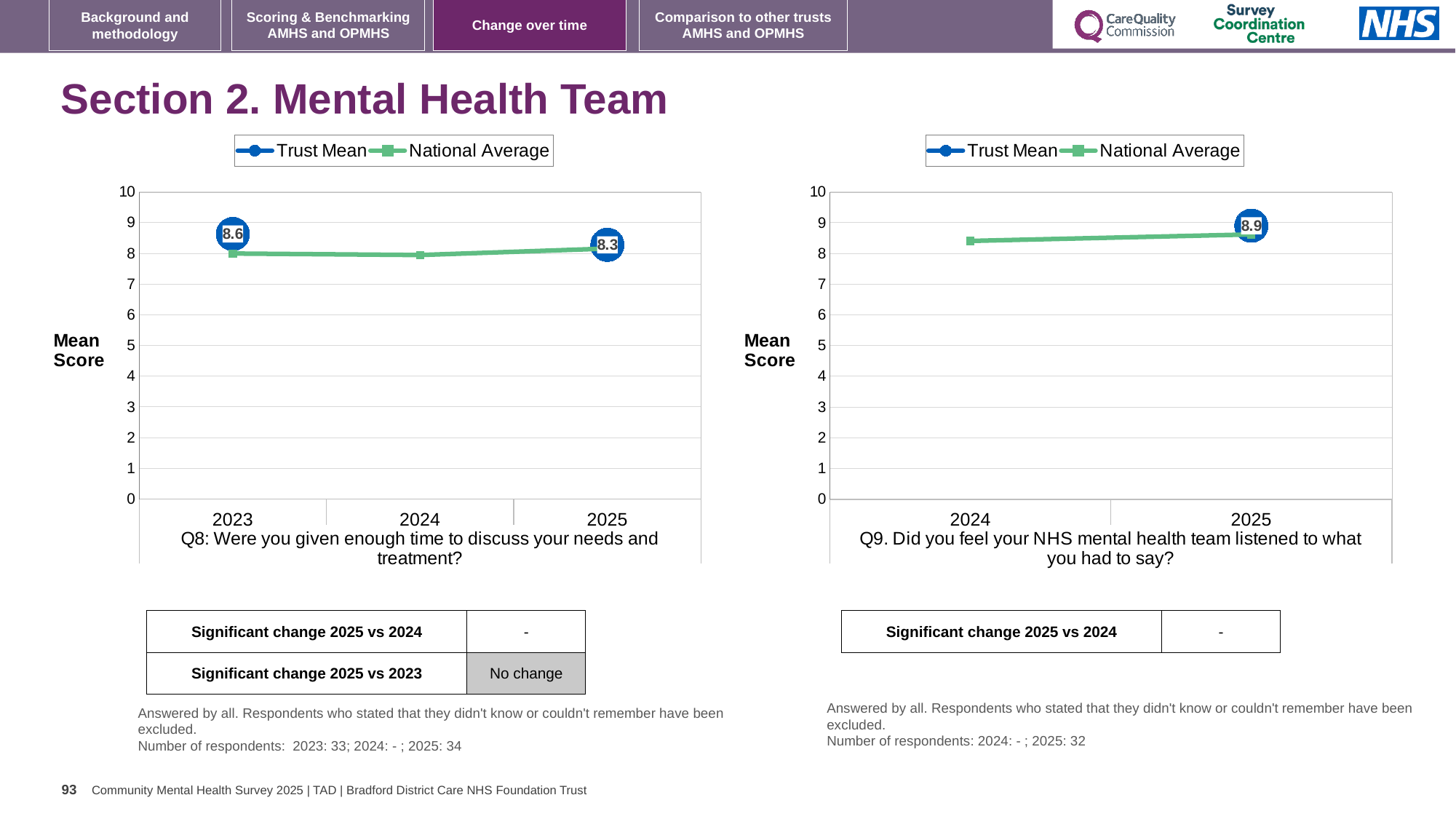
In the Q8 chart (left), what is the Trust Mean for 2023? 8.6 What kind of chart is the Q9 chart (right)? line chart In the Q8 chart (left), does the Trust Mean rise or fall from 2023 to 2025? fall How many years are shown on the x axis of the Q8 chart (left)? 3 In the Q9 chart (right), is the National Average for 2024 greater or less than 7? greater In the Q9 chart (right), what is the Trust Mean for 2025? 8.9 In the Q8 chart (left), what is the Trust Mean for 2025? 8.3 In the Q8 chart (left), is the National Average for 2024 greater or less than 9? less What are the two series named in the legend of the Q8 chart (left)? Trust Mean and National Average How many series does the legend of the Q9 chart (right) list? 2 In the Q8 chart (left), what is the difference between the Trust Mean for 2023 and the Trust Mean for 2025? 0.3 In the Q8 chart (left), which year has the higher Trust Mean, 2023 or 2025? 2023